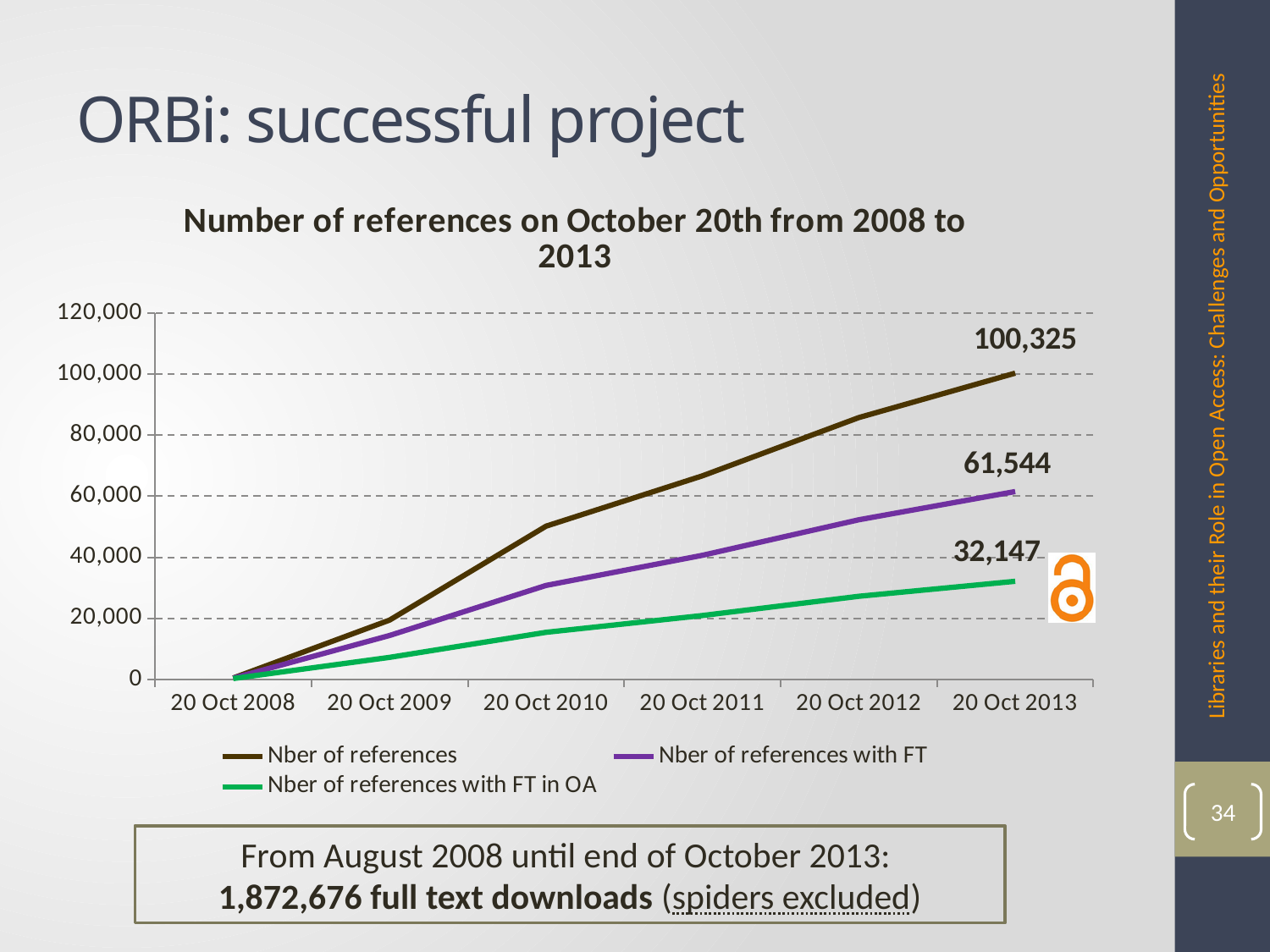
Which series has the highest value on 20 Oct 2013? Nber of references What is the difference between Nber of references with FT and Nber of references with FT in OA on 20 Oct 2013? 29,397 Is the value for Nber of references with FT in OA on 20 Oct 2012 greater or less than 40,000? less Which series has the lowest value on 20 Oct 2013? Nber of references with FT in OA Is the value for Nber of references on 20 Oct 2011 greater or less than 60,000? greater What is the difference between Nber of references and Nber of references with FT on 20 Oct 2013? 38,781 What kind of chart is shown on the slide? Line chart How many series does the legend list? 3 What is the value for Nber of references with FT on 20 Oct 2013? 61,544 How many dates are shown on the x axis? 6 What is the value for Nber of references on 20 Oct 2013? 100,325 What is the value for Nber of references with FT in OA on 20 Oct 2013? 32,147